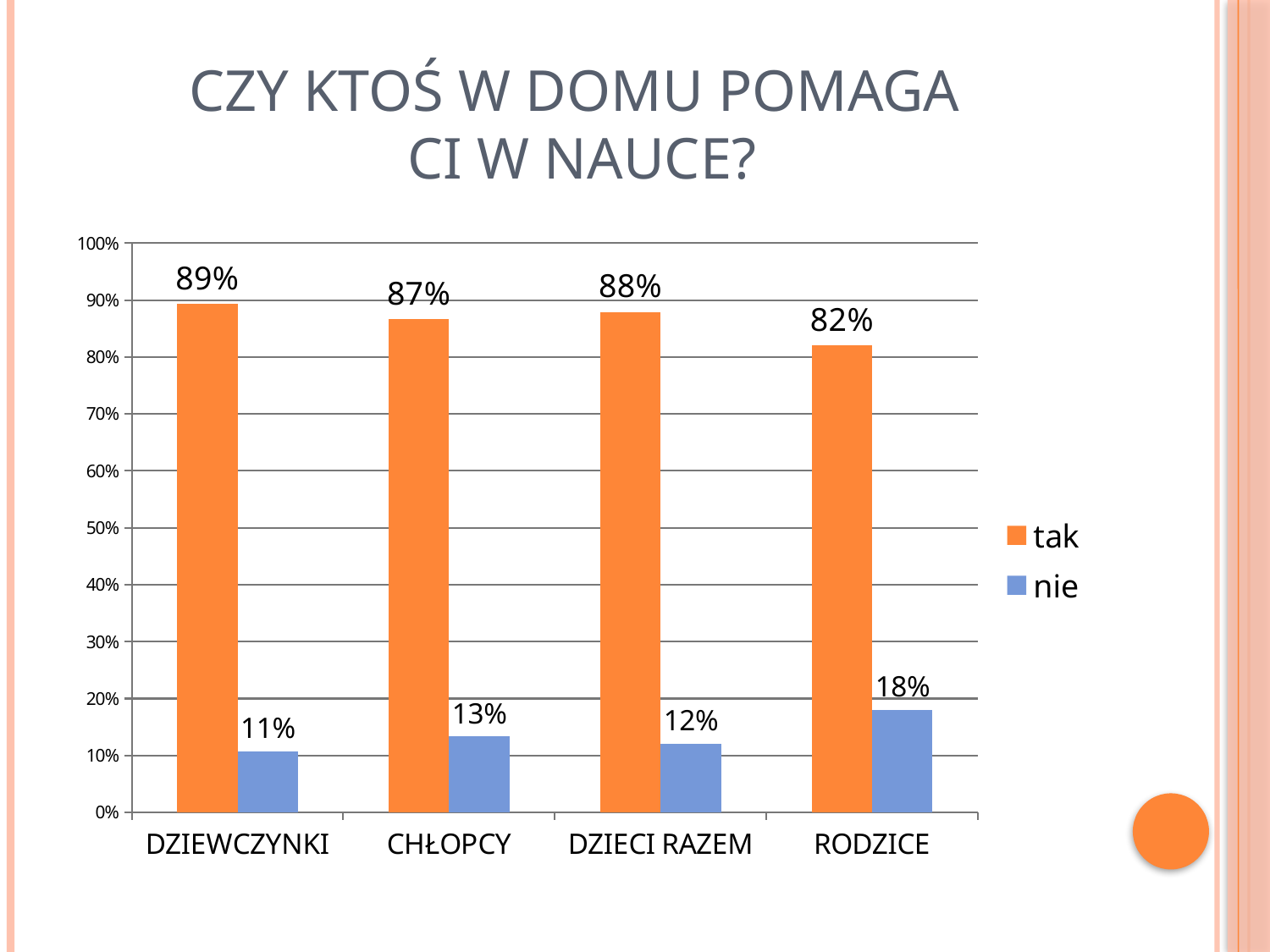
What kind of chart is shown on the slide? bar chart Which category has the highest 'tak' value? DZIEWCZYNKI What is the difference between the 'tak' values for DZIEWCZYNKI and RODZICE? 7% What is the 'nie' value for DZIECI RAZEM? 12% Which is larger: the 'nie' value for CHŁOPCY or the 'nie' value for DZIECI RAZEM? CHŁOPCY How many categories are shown on the x axis? 4 What is the 'tak' value for DZIEWCZYNKI? 89% What is the 'tak' value for CHŁOPCY? 87% Which category has the lowest 'nie' value? DZIEWCZYNKI What colour are the 'tak' bars? orange How many series does the legend list? 2 What is the 'nie' value for RODZICE? 18%